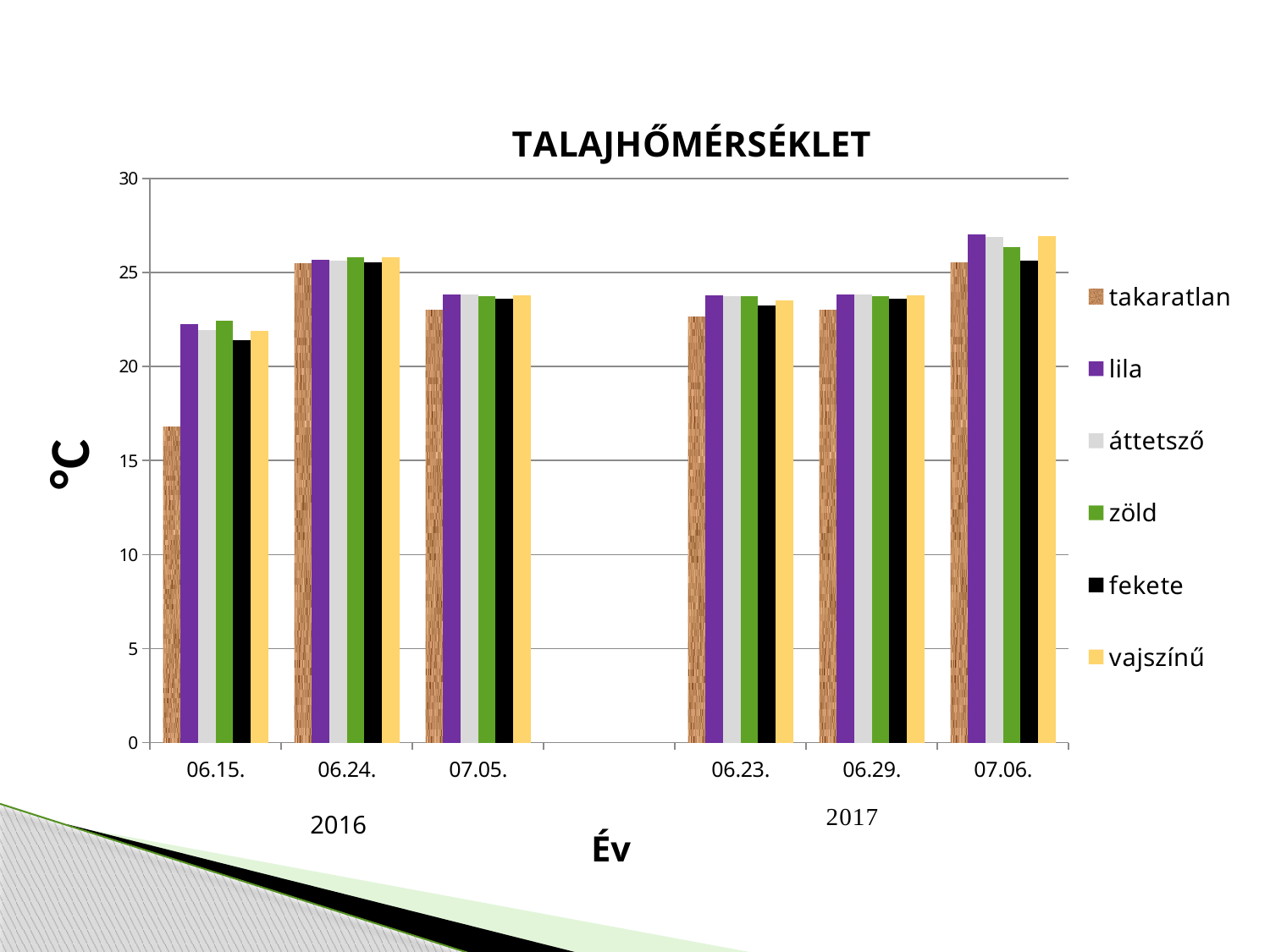
Is the value for vajszínű on 07.05. greater or less than 25? less Is the value for takaratlan on 06.24. greater or less than 25? greater On which date is the takaratlan value lowest? 06.15. Is the value for takaratlan on 06.15. greater or less than 20? less What kind of chart is shown on the slide? bar chart On 06.15., which is larger: takaratlan or lila? lila How many series does the legend list? 6 How many date categories are shown on the x axis? 6 Does the takaratlan value rise or fall from 06.15. to 06.24.? rise What is the title of the chart? TALAJHŐMÉRSÉKLET On which date is the lila value highest? 07.06.